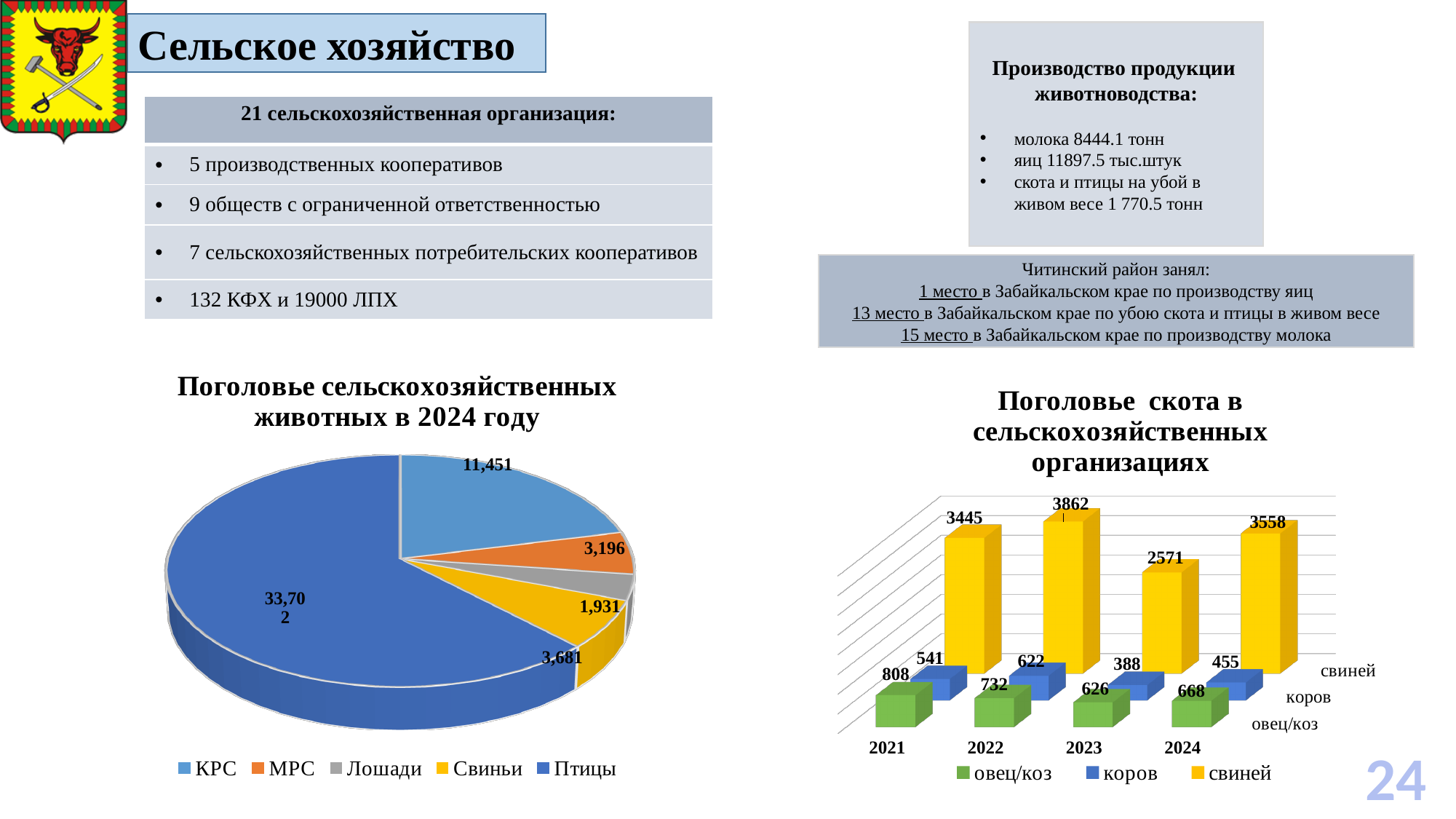
In the pie chart "Поголовье сельскохозяйственных животных в 2024 году", what is the value for МРС? 3,196 In the pie chart "Поголовье сельскохозяйственных животных в 2024 году", which category has the largest slice? Птицы What kind of chart is the chart titled "Поголовье сельскохозяйственных животных в 2024 году"? pie chart In the chart "Поголовье скота в сельскохозяйственных организациях", what is the value for свиней in 2022? 3862 What kind of chart is the chart titled "Поголовье скота в сельскохозяйственных организациях"? bar chart In the pie chart "Поголовье сельскохозяйственных животных в 2024 году", what is the value for Птицы? 33,702 In the chart "Поголовье скота в сельскохозяйственных организациях", what is the difference between the свиней values for 2022 and 2023? 1291 In the chart "Поголовье скота в сельскохозяйственных организациях", what is the value for коров in 2023? 388 In the pie chart "Поголовье сельскохозяйственных животных в 2024 году", what is the value for КРС? 11,451 How many series does the legend of the chart "Поголовье скота в сельскохозяйственных организациях" list? 3 In the chart "Поголовье скота в сельскохозяйственных организациях", in which year is the value for свиней the lowest? 2023 How many categories does the legend of the pie chart "Поголовье сельскохозяйственных животных в 2024 году" list? 5